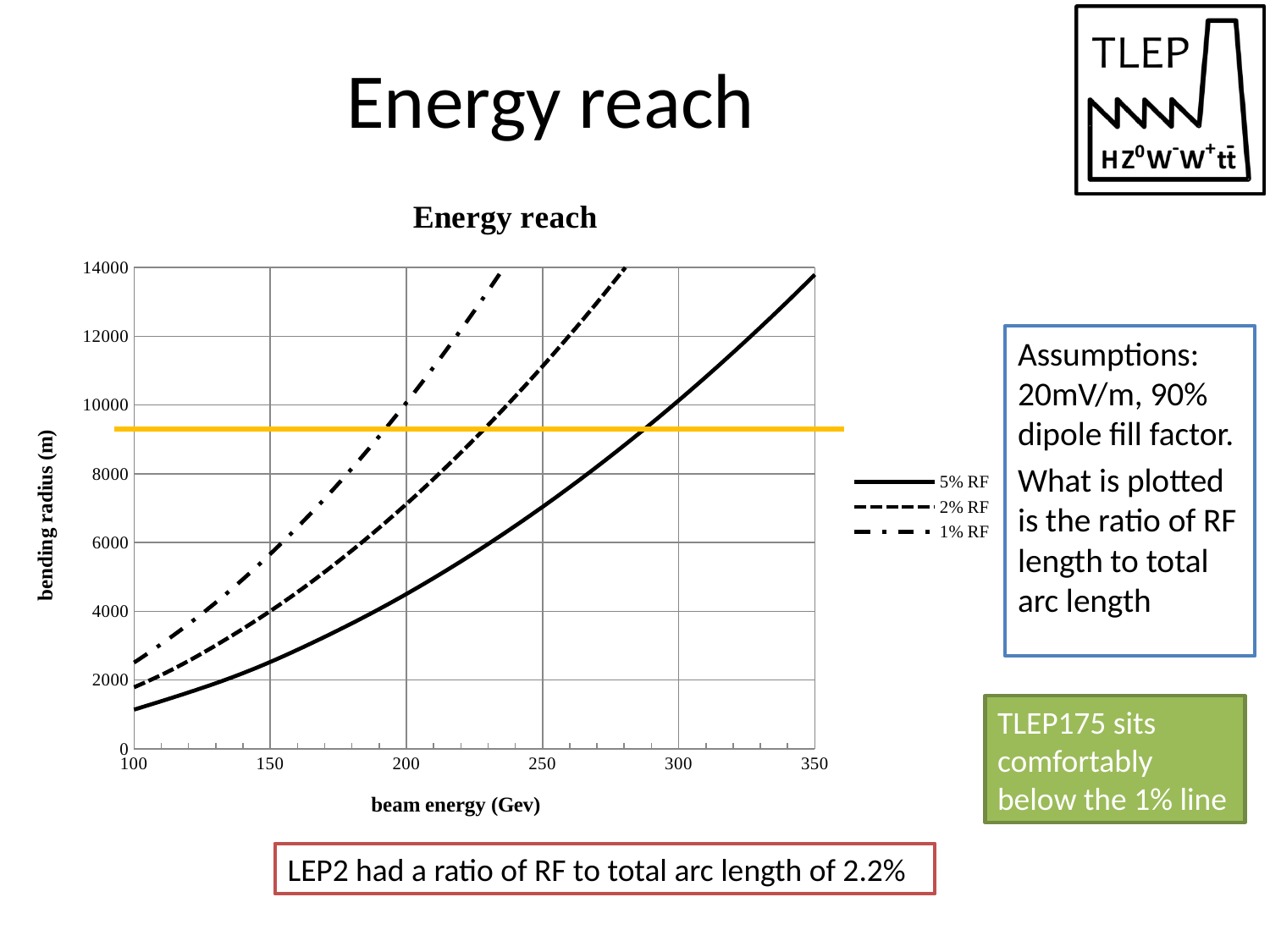
How many series does the chart legend list? 3 Is the bending radius for the 5% RF series at 350 GeV greater or less than 12000? greater Is the bending radius for the 1% RF series at 150 GeV greater or less than 4000? greater What is the title of the chart? Energy reach At a beam energy of 200 GeV, which series has the larger bending radius, 1% RF or 5% RF? 1% RF What kind of chart is shown on the slide? line chart Is the bending radius for the 5% RF series at 100 GeV greater or less than 2000? less What is the label of the y axis of the chart? bending radius (m) Do the bending radius values rise or fall as beam energy increases along the x axis? rise At a beam energy of 250 GeV, which series has the larger bending radius, 2% RF or 5% RF? 2% RF